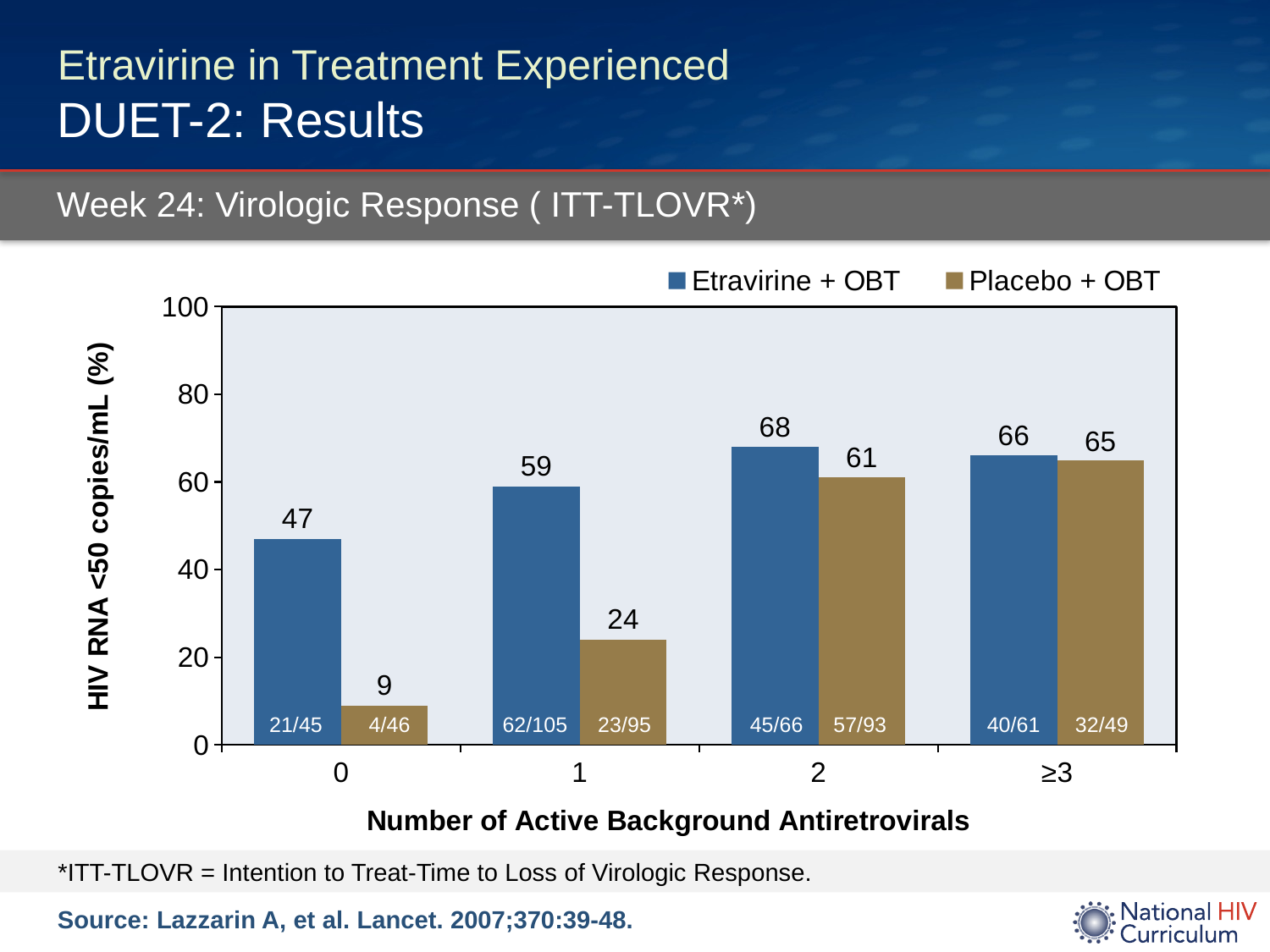
What is the value for Placebo + OBT at 1 active background antiretroviral? 24 What is the value for Placebo + OBT at ≥3 active background antiretrovirals? 65 What kind of chart is shown on the slide? Bar chart Which number of active background antiretrovirals has the lowest value for Placebo + OBT? 0 How many categories are shown on the x axis? 4 Do the Placebo + OBT values rise or fall as the number of active background antiretrovirals increases? Rise Which is larger at 1 active background antiretroviral: Etravirine + OBT or Placebo + OBT? Etravirine + OBT Which number of active background antiretrovirals has the highest value for Etravirine + OBT? 2 What is the value for Etravirine + OBT at 0 active background antiretrovirals? 47 What is the difference between Etravirine + OBT and Placebo + OBT at 2 active background antiretrovirals? 7 How many series does the legend list? 2 What is the difference between Etravirine + OBT and Placebo + OBT at 0 active background antiretrovirals? 38